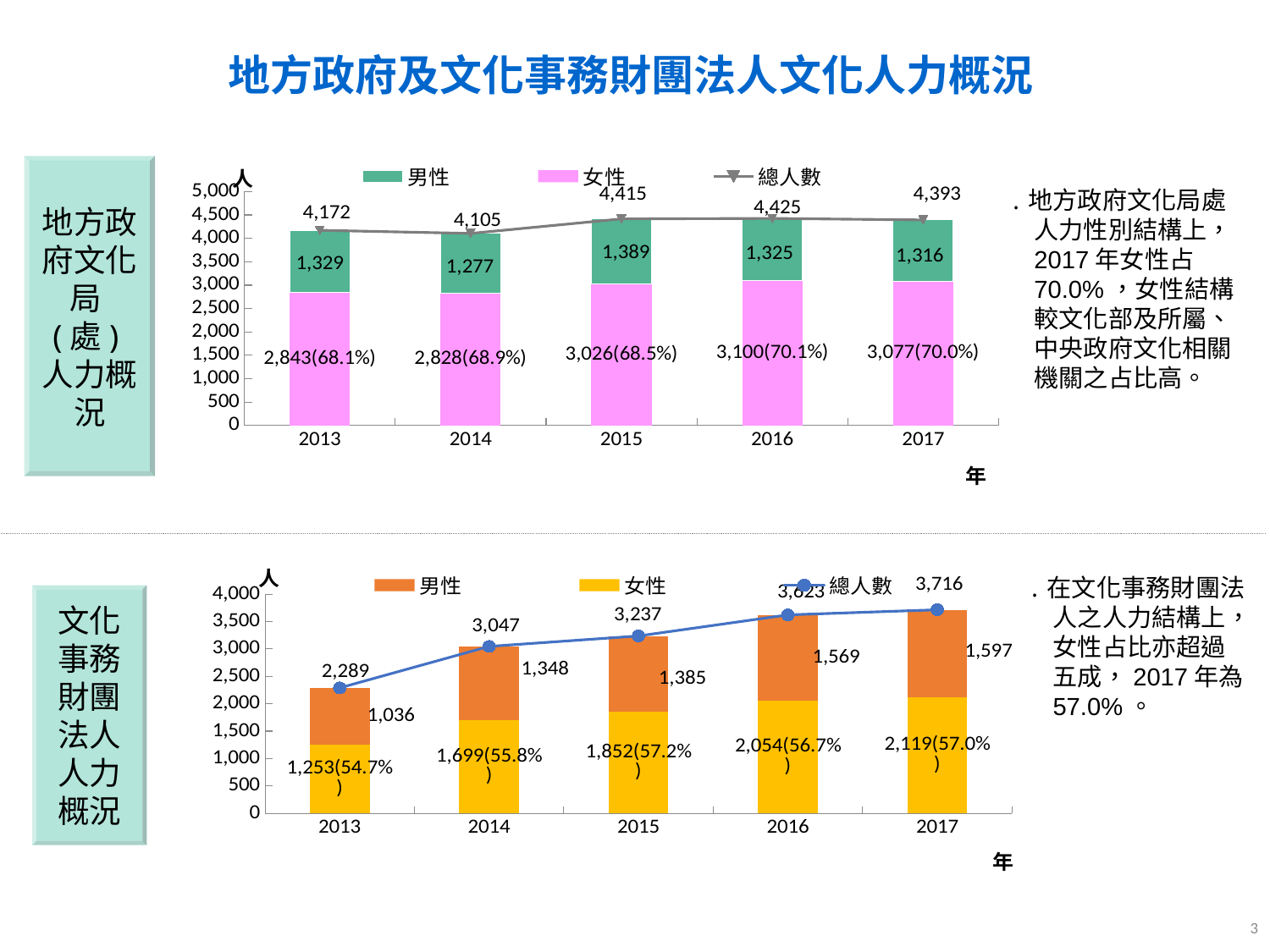
In the bottom chart (文化事務財團法人人力概況), does the 總人數 rise or fall from 2013 to 2017? rise In the top chart (地方政府文化局（處）人力概況), which year has the lowest 男性 value? 2014 In the top chart (地方政府文化局（處）人力概況), what is the 總人數 value for 2013? 4,172 In the bottom chart (文化事務財團法人人力概況), how many years are shown on the x axis? 5 In the top chart (地方政府文化局（處）人力概況), what is the 男性 value for 2015? 1,389 In the top chart (地方政府文化局（處）人力概況), how many series does the legend list? 3 In the top chart (地方政府文化局（處）人力概況), what is the 女性 value for 2016? 3,100(70.1%) In the top chart (地方政府文化局（處）人力概況), which year has the highest 總人數? 2016 In the bottom chart (文化事務財團法人人力概況), what is the 女性 value for 2017? 2,119(57.0%) In the top chart (地方政府文化局（處）人力概況), what is the difference between the 總人數 for 2015 and 2014? 310 In the bottom chart (文化事務財團法人人力概況), what is the 總人數 value for 2014? 3,047 In the bottom chart (文化事務財團法人人力概況), what is the 男性 value for 2013? 1,036